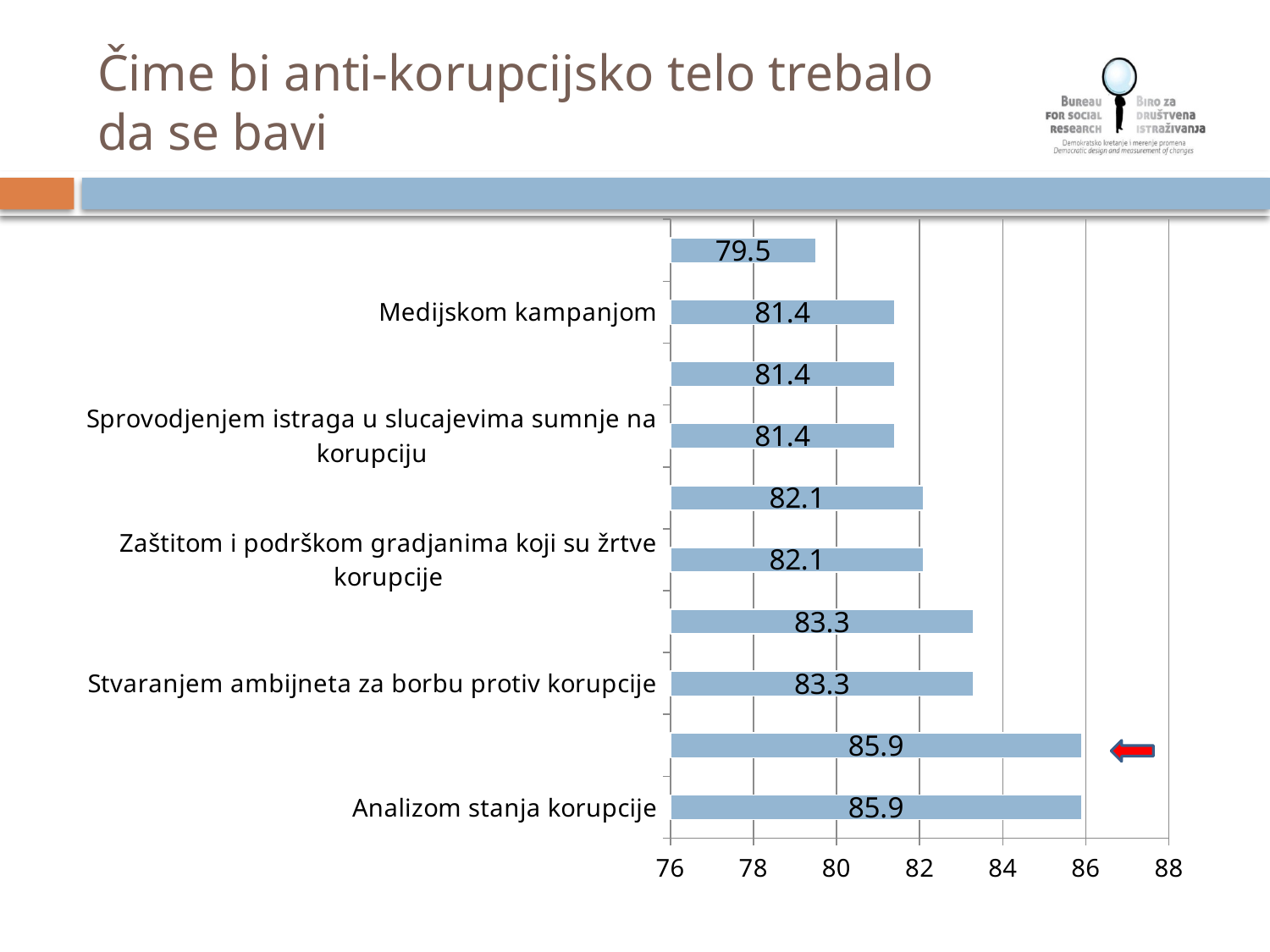
What is the value for Analizom stanja korupcije? 85.9 Which labeled category has the highest value? Analizom stanja korupcije What is the lowest value shown on the chart? 79.5 What is the value for Stvaranjem ambijneta za borbu protiv korupcije? 83.3 What is the difference between the values for Analizom stanja korupcije and Medijskom kampanjom? 4.5 What is the value for Zaštitom i podrškom gradjanima koji su žrtve korupcije? 82.1 What is the difference between the values for Stvaranjem ambijneta za borbu protiv korupcije and Zaštitom i podrškom gradjanima koji su žrtve korupcije? 1.2 What is the value for Medijskom kampanjom? 81.4 What kind of chart is shown on the slide? bar chart Which is larger: the value for Stvaranjem ambijneta za borbu protiv korupcije or for Sprovodjenjem istraga u slucajevima sumnje na korupciju? Stvaranjem ambijneta za borbu protiv korupcije Is the value for Analizom stanja korupcije greater or less than 84? greater How many bars are plotted on the chart? 10